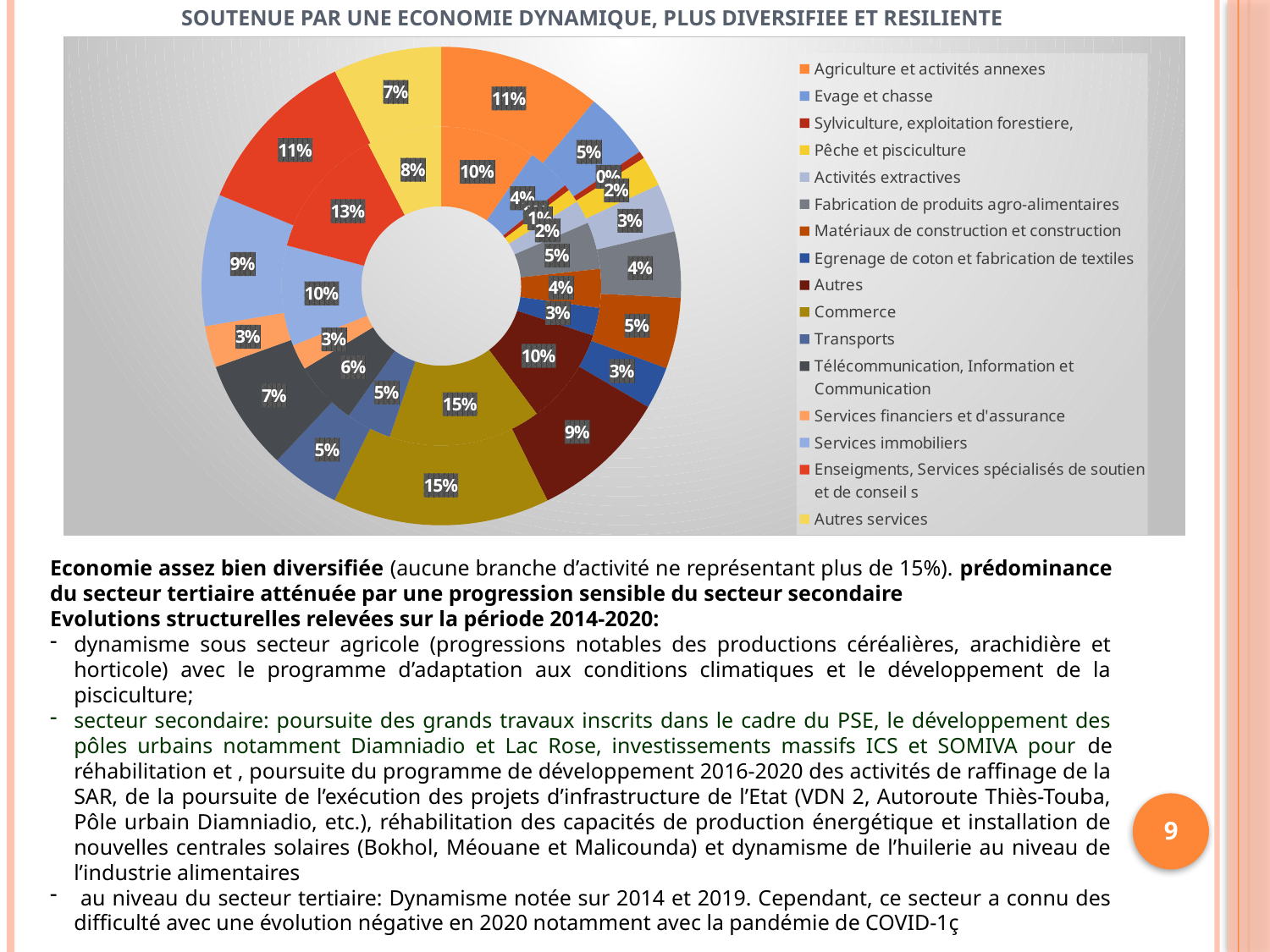
How many categories does the legend of the chart list? 16 In the outer ring, what is the difference between the share of Commerce (15%) and the share of Télécommunication, Information et Communication (7%)? 8% In the outer ring, which is larger: Commerce or Télécommunication, Information et Communication? Commerce What is the share of Evage et chasse in the outer ring of the chart? 5% Which category has the smallest share in the outer ring of the chart? Sylviculture, exploitation forestiere What is the share of Agriculture et activités annexes in the outer ring of the chart? 11% Which category has the largest share in the outer ring of the chart? Commerce What is the last entry listed in the chart legend? Autres services What colour represents Commerce in the chart legend? Olive/gold What kind of chart is shown on the slide? Doughnut chart What is the share of Sylviculture, exploitation forestiere in the outer ring of the chart? 0% What is the share of Commerce in the outer ring of the chart? 15%